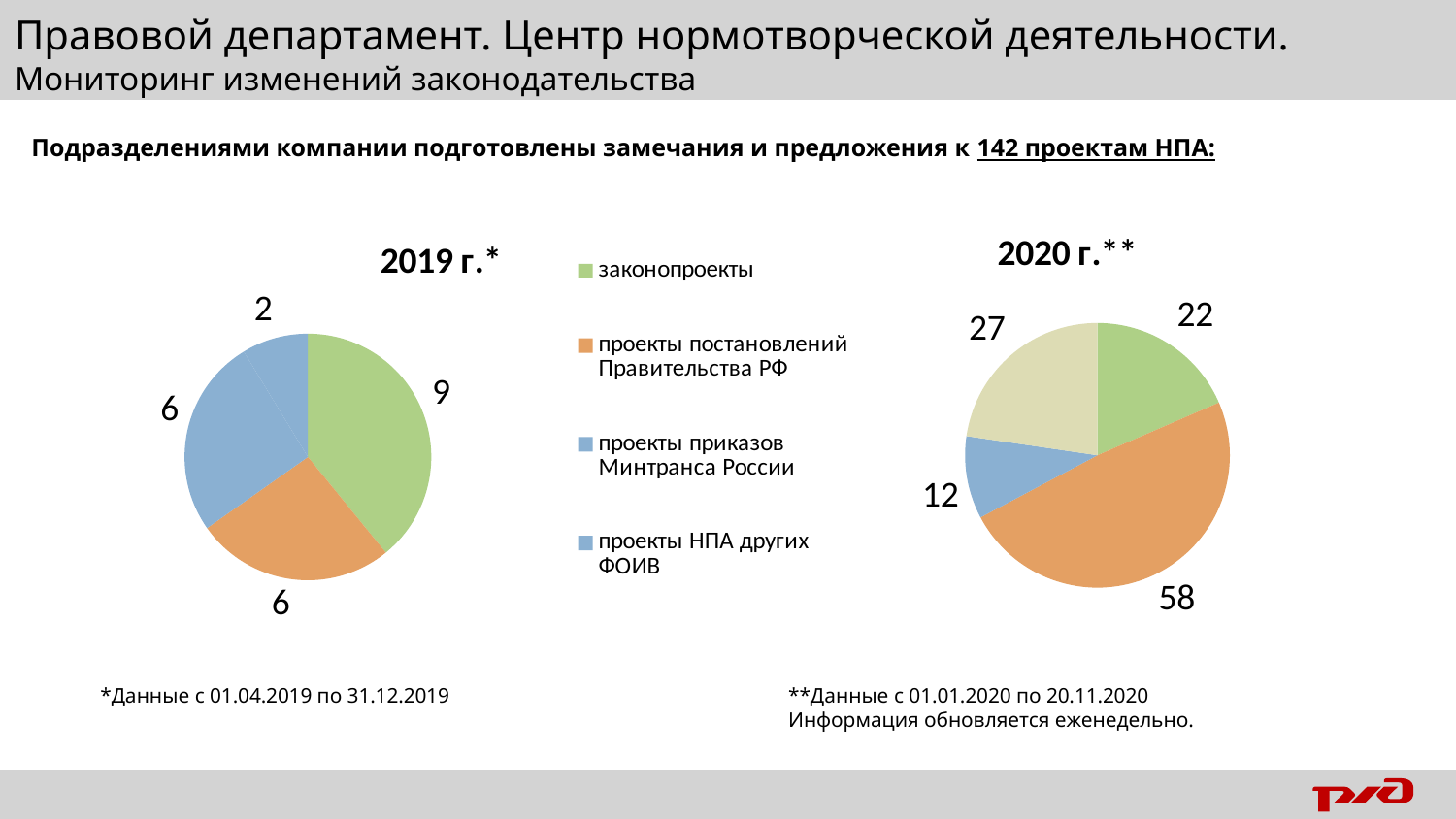
In the 2020 г. pie chart, what is the value for проекты приказов Минтранса России? 12 In the 2019 г. pie chart, which category has the largest slice? законопроекты In the 2020 г. pie chart, what is the difference between the largest slice (58) and the законопроекты slice (22)? 36 How many slices does the 2020 г. pie chart have? 4 In the 2020 г. pie chart, which category has the largest slice? проекты постановлений Правительства РФ What kind of charts are shown on the slide? Pie charts In the 2019 г. pie chart, what is the value for законопроекты? 9 What is the total of all slices in the 2019 г. pie chart? 23 What is the total of all slices in the 2020 г. pie chart? 119 In the 2020 г. pie chart, what is the value for проекты постановлений Правительства РФ? 58 How many categories does the legend list? 4 Which is larger: the законопроекты value in the 2020 г. chart or in the 2019 г. chart? 2020 г.